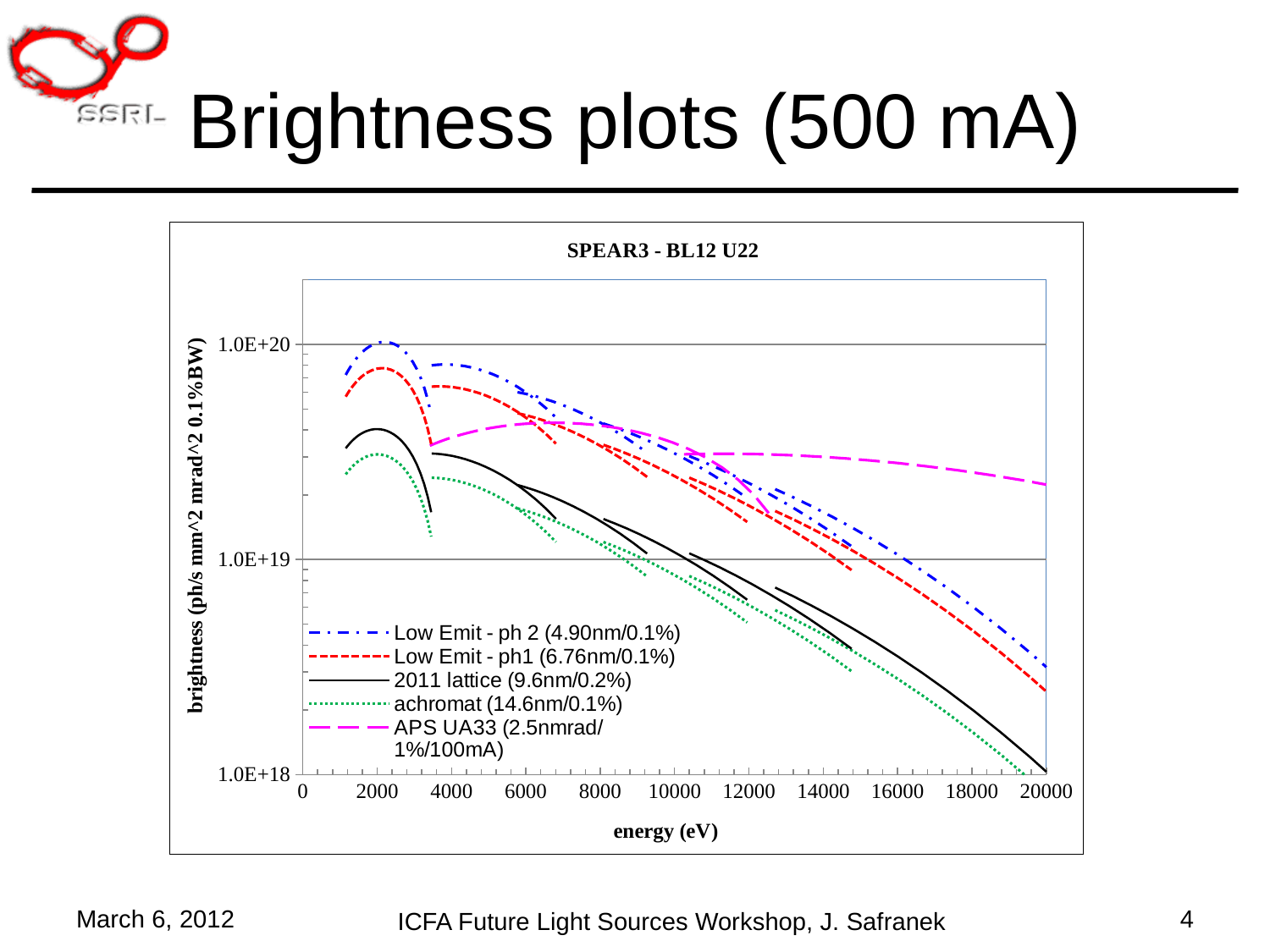
What kind of chart is shown on the slide? line chart Is the brightness of the APS UA33 series at 20000 eV greater or less than 1.0E+19? greater How many series does the chart legend list? 5 Is the brightness of the Low Emit - ph 2 series at 20000 eV greater or less than 1.0E+19? less Is the peak brightness of the Low Emit - ph1 series greater or less than 1.0E+20? less Does the brightness of the Low Emit - ph 2 series rise or fall between 10000 eV and 20000 eV? fall What is the label of the x axis? energy (eV) At 20000 eV, which is larger: the brightness of APS UA33 or of Low Emit - ph1? APS UA33 Which series has the lowest brightness at 18000 eV? achromat (14.6nm/0.1%) Which series has the highest brightness at 20000 eV? APS UA33 (2.5nmrad/1%/100mA) What is the title of the chart? SPEAR3 - BL12 U22